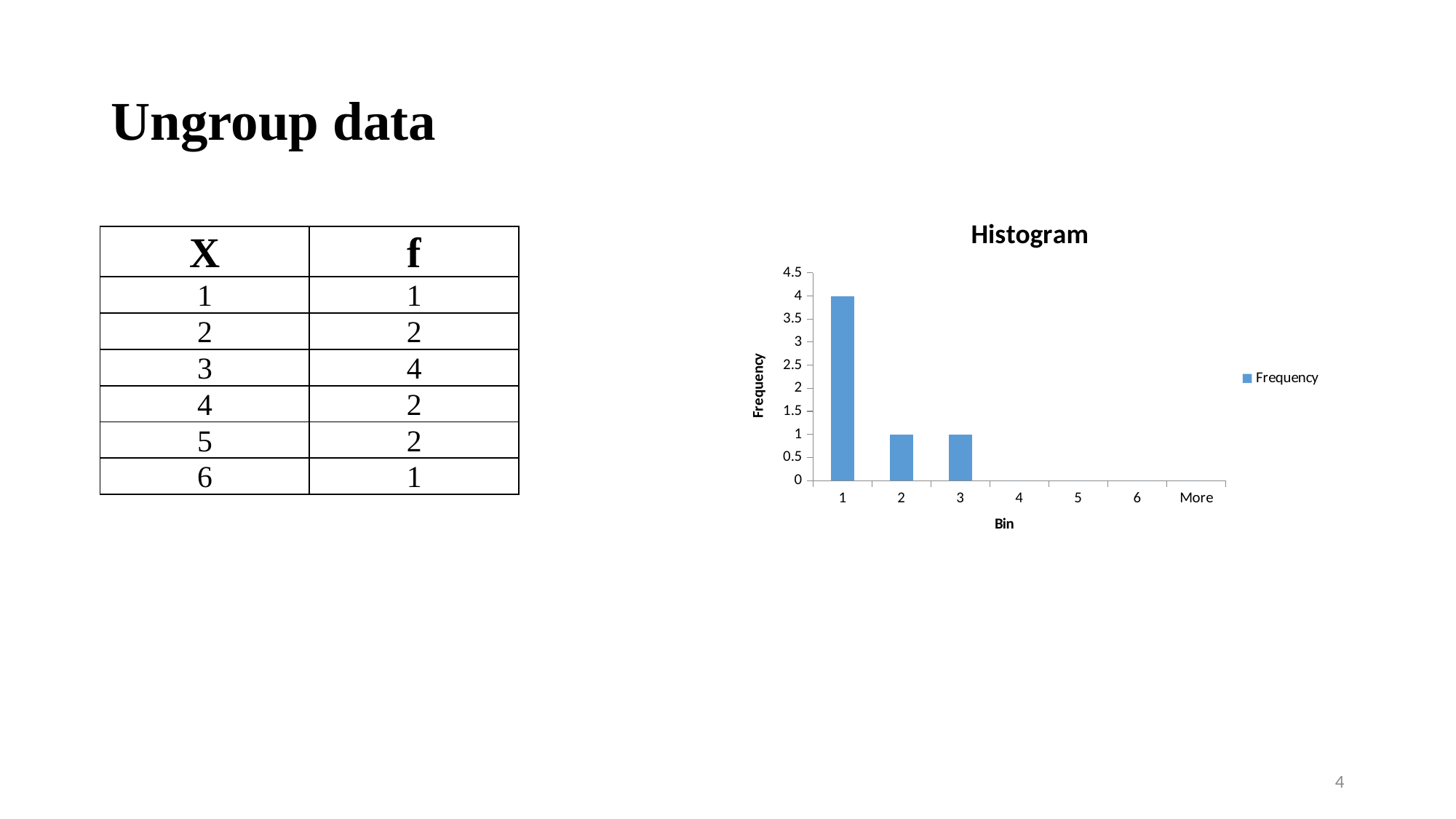
Which has a larger frequency, bin 1 or bin 3? bin 1 Which bin has the highest frequency in the Histogram chart? 1 Is the frequency for bin 1 greater or less than 3? greater What kind of chart is the Histogram chart? bar chart What is the frequency for bin 2 in the Histogram chart? 1 Do the frequencies rise or fall from bin 1 to bin 3? fall How many bins are shown on the x axis of the Histogram chart? 7 What is the frequency for bin 3 in the Histogram chart? 1 What is the frequency for bin 1 in the Histogram chart? 4 What is the label of the x axis of the Histogram chart? Bin What is the difference between the frequency for bin 1 and the frequency for bin 2? 3 How many series does the legend of the Histogram chart list? 1